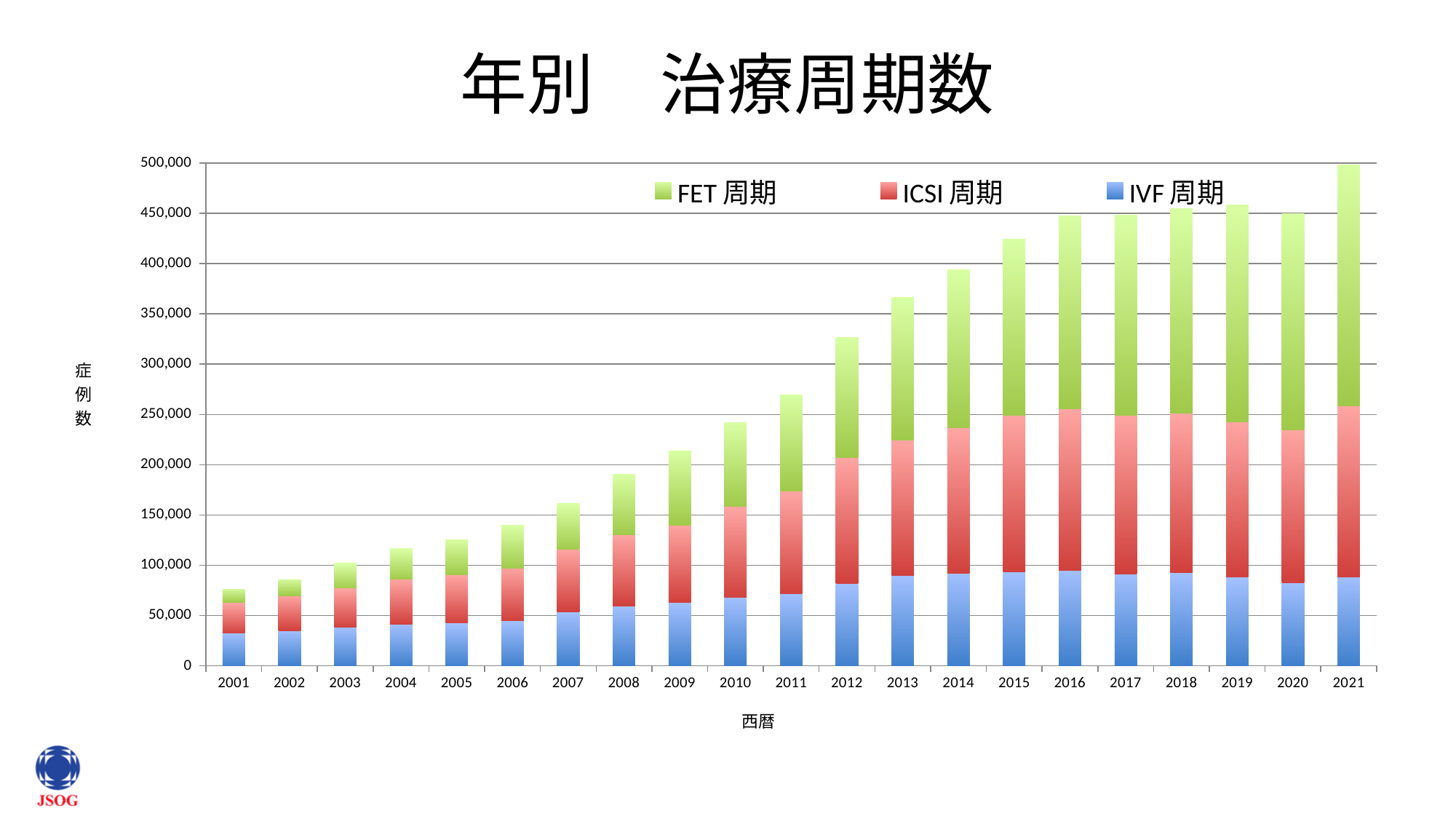
Is the total value for 2001 greater or less than 100,000? less How many years are shown along the x axis of the chart? 21 What is the title of the chart? 年別 治療周期数 Do the total treatment cycles generally rise or fall from 2001 to 2021? rise Which year has the highest total number of treatment cycles? 2021 What kind of chart is shown on the slide? Stacked bar chart Which year has a larger total, 2012 or 2013? 2013 Is the total value for 2012 greater or less than 300,000? greater Which year has the lowest total number of treatment cycles? 2001 Is the total value for 2021 greater or less than 450,000? greater How many series does the chart's legend list? 3